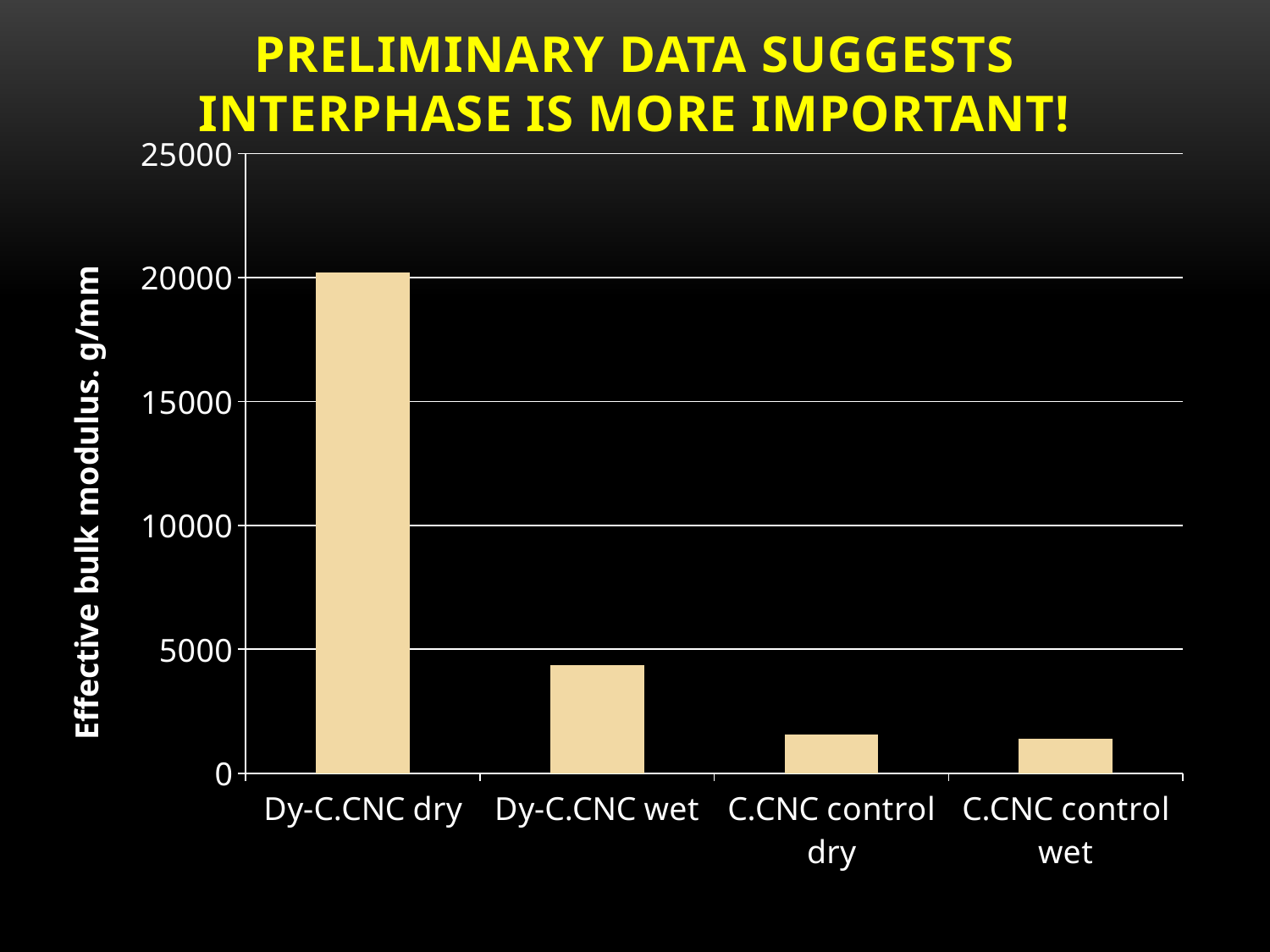
What is the label of the y axis? Effective bulk modulus. g/mm Is the value for Dy-C.CNC wet greater or less than 5000? less What is the title of the slide? PRELIMINARY DATA SUGGESTS INTERPHASE IS MORE IMPORTANT! Is the value for C.CNC control dry greater or less than 5000? less How many categories are plotted on the x axis? 4 Which category has the highest effective bulk modulus? Dy-C.CNC dry Which is larger, the value for Dy-C.CNC wet or C.CNC control dry? Dy-C.CNC wet Is the value for C.CNC control wet greater or less than 5000? less What kind of chart is shown on the slide? bar chart Which is larger, the value for Dy-C.CNC dry or Dy-C.CNC wet? Dy-C.CNC dry Do the bar values rise or fall from left to right along the x axis? fall